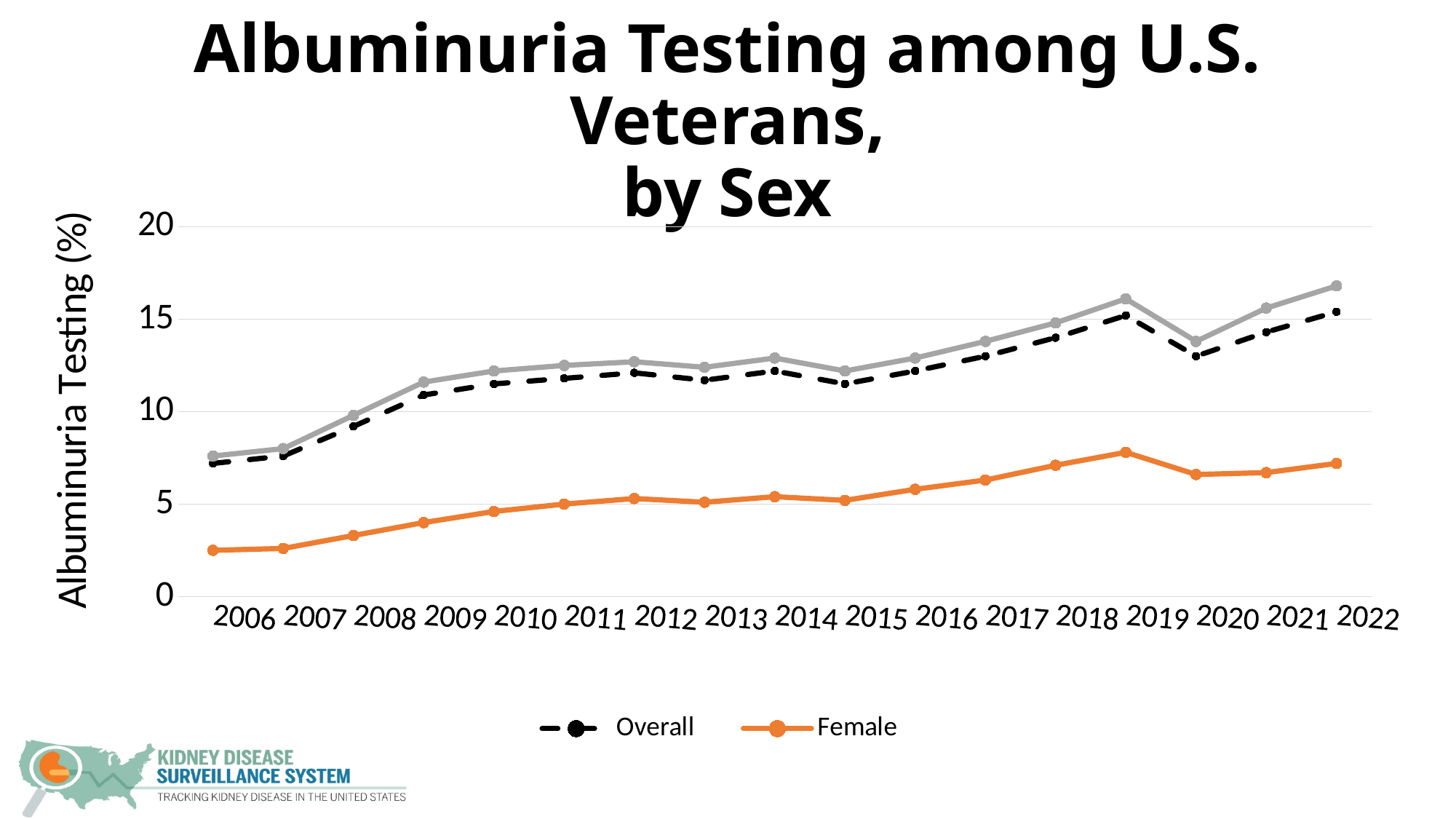
In which year is the Overall value lowest? 2006 Is the Overall value for 2010 greater or less than 10? greater How many years are plotted along the x axis? 17 What kind of chart is shown on the slide? line chart What is the title of the chart? Albuminuria Testing among U.S. Veterans, by Sex In which year is the Female value highest? 2019 Is the Female value for 2022 greater or less than 10? less Is the Female value for 2006 greater or less than 5? less What is the label on the vertical axis? Albuminuria Testing (%) How many series does the legend list? 2 Does the Female line rise or fall from 2006 to 2018? rise In 2015, which is larger, the Overall value or the Female value? Overall